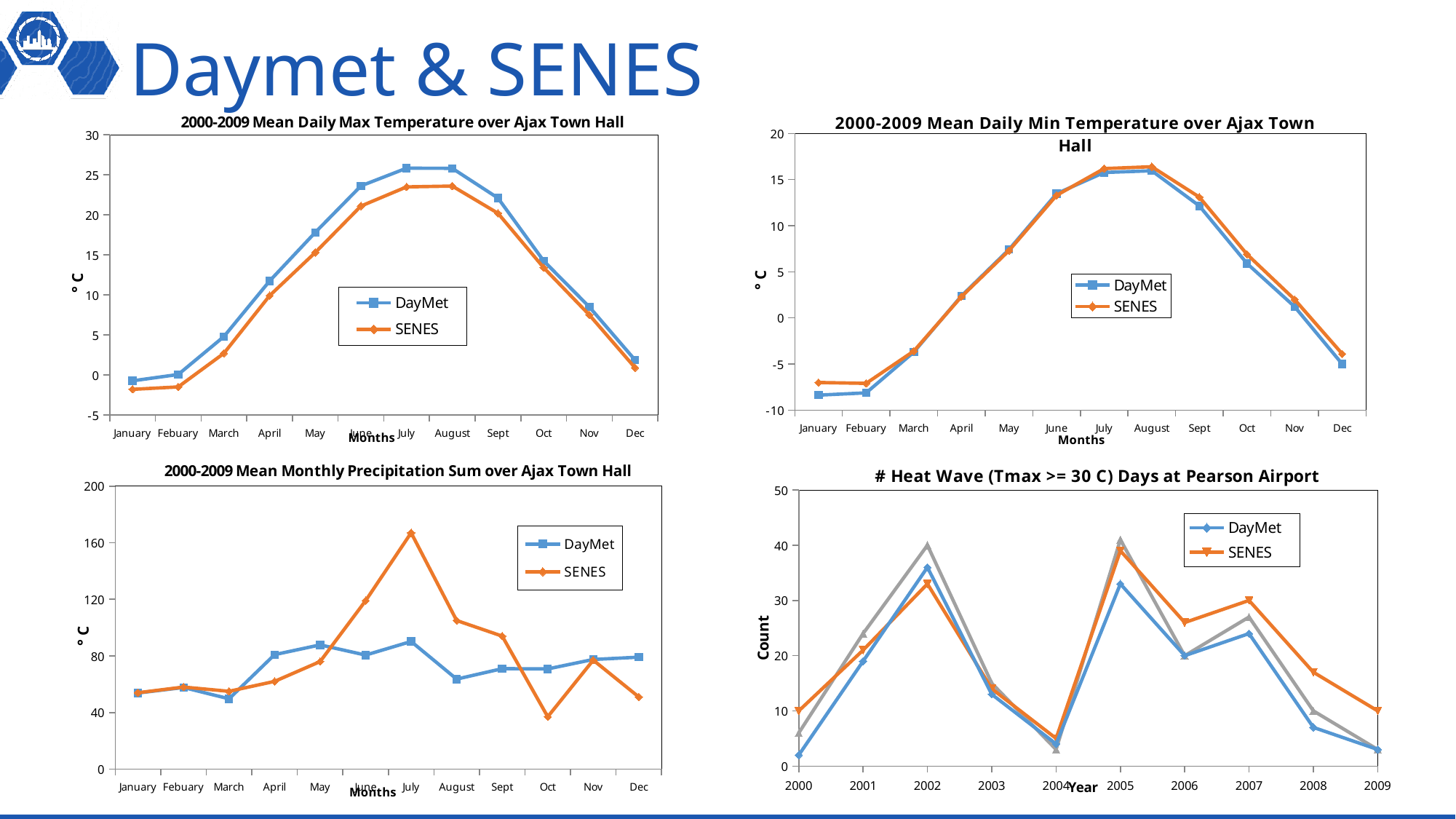
In the '2000-2009 Mean Monthly Precipitation Sum over Ajax Town Hall' chart, which month has the lowest SENES value? Oct What kind of chart is the '2000-2009 Mean Daily Max Temperature over Ajax Town Hall' chart? Line chart In the '2000-2009 Mean Daily Min Temperature over Ajax Town Hall' chart, is the DayMet value for January greater or less than -5? less In the '2000-2009 Mean Daily Max Temperature over Ajax Town Hall' chart, which month has the lowest SENES value? January In the '2000-2009 Mean Daily Max Temperature over Ajax Town Hall' chart, is the SENES value for July greater or less than 25? less In the '2000-2009 Mean Monthly Precipitation Sum over Ajax Town Hall' chart, which month has the highest SENES value? July In the '2000-2009 Mean Daily Max Temperature over Ajax Town Hall' chart, how many series does the legend list? 2 In the '2000-2009 Mean Monthly Precipitation Sum over Ajax Town Hall' chart, is the SENES value for July greater or less than 160? greater In the '2000-2009 Mean Daily Max Temperature over Ajax Town Hall' chart, which series is higher in July, DayMet or SENES? DayMet In the '2000-2009 Mean Daily Min Temperature over Ajax Town Hall' chart, how many months are plotted on the x axis? 12 In the '# Heat Wave (Tmax >= 30 C) Days at Pearson Airport' chart, which year has the highest SENES value? 2005 In the '# Heat Wave (Tmax >= 30 C) Days at Pearson Airport' chart, do the SENES values rise or fall from 2007 to 2009? fall